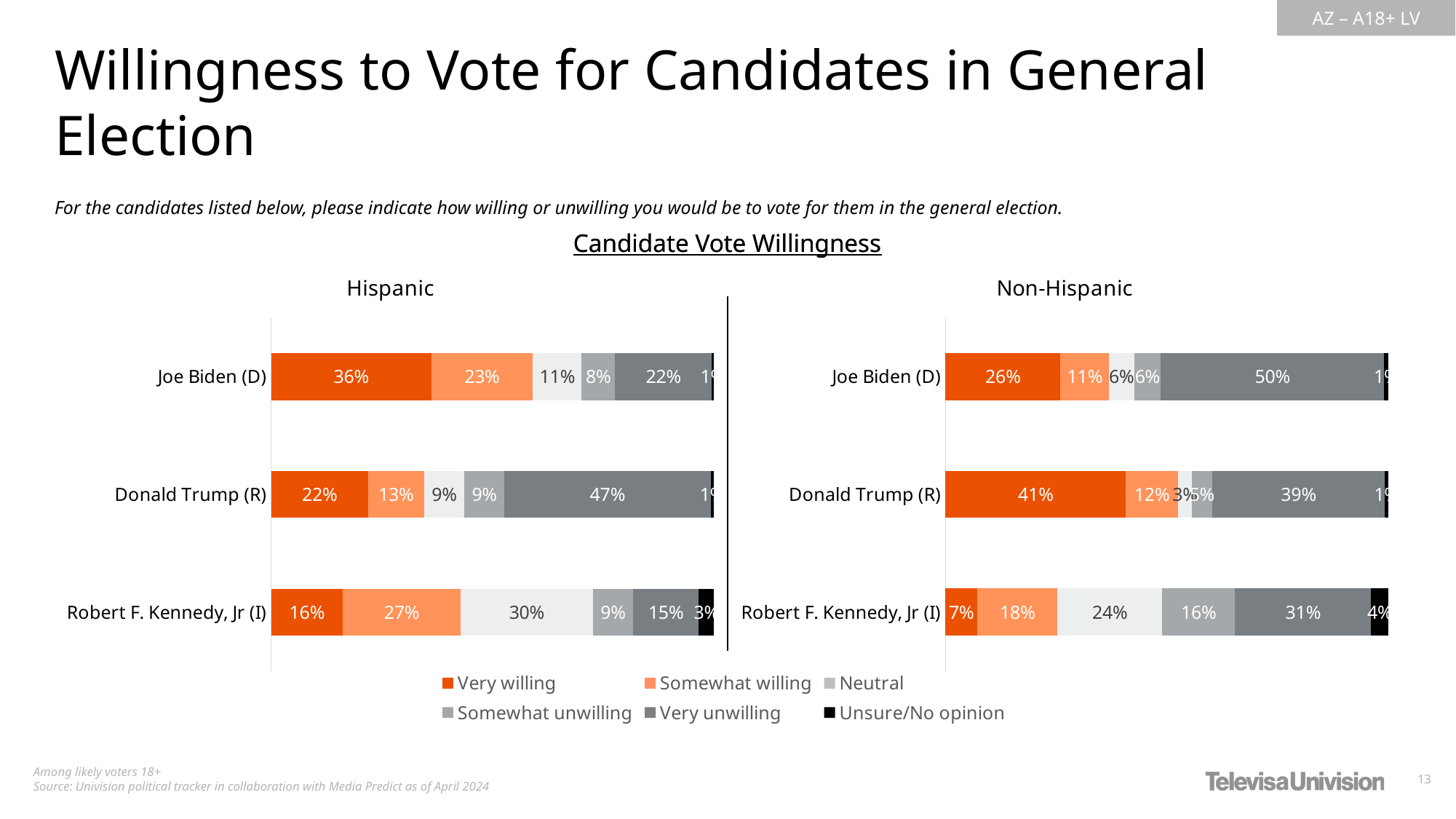
How many series does the legend list? 6 In the Hispanic chart, what is the Somewhat unwilling value for Joe Biden (D)? 8% In the Non-Hispanic chart, what percentage of respondents are Very unwilling to vote for Joe Biden (D)? 50% In the Hispanic chart, what is the difference in percentage points between the Very willing values for Joe Biden (D) and Donald Trump (R)? 14 percentage points In the Non-Hispanic chart, which candidate has the highest Very willing percentage? Donald Trump (R) In the Hispanic chart, which candidate has the larger Somewhat willing value, Joe Biden (D) or Robert F. Kennedy, Jr (I)? Robert F. Kennedy, Jr (I) In the Non-Hispanic chart, which candidate has the lowest Very willing percentage? Robert F. Kennedy, Jr (I) In the Hispanic chart, which candidate has the highest Very unwilling percentage? Donald Trump (R) In the Non-Hispanic chart, what is the Unsure/No opinion value for Robert F. Kennedy, Jr (I)? 4% What kind of chart is used to show the Non-Hispanic data? Stacked bar chart How many candidates are shown in the Hispanic chart? 3 In the Hispanic chart, what percentage of respondents are Very willing to vote for Joe Biden (D)? 36%